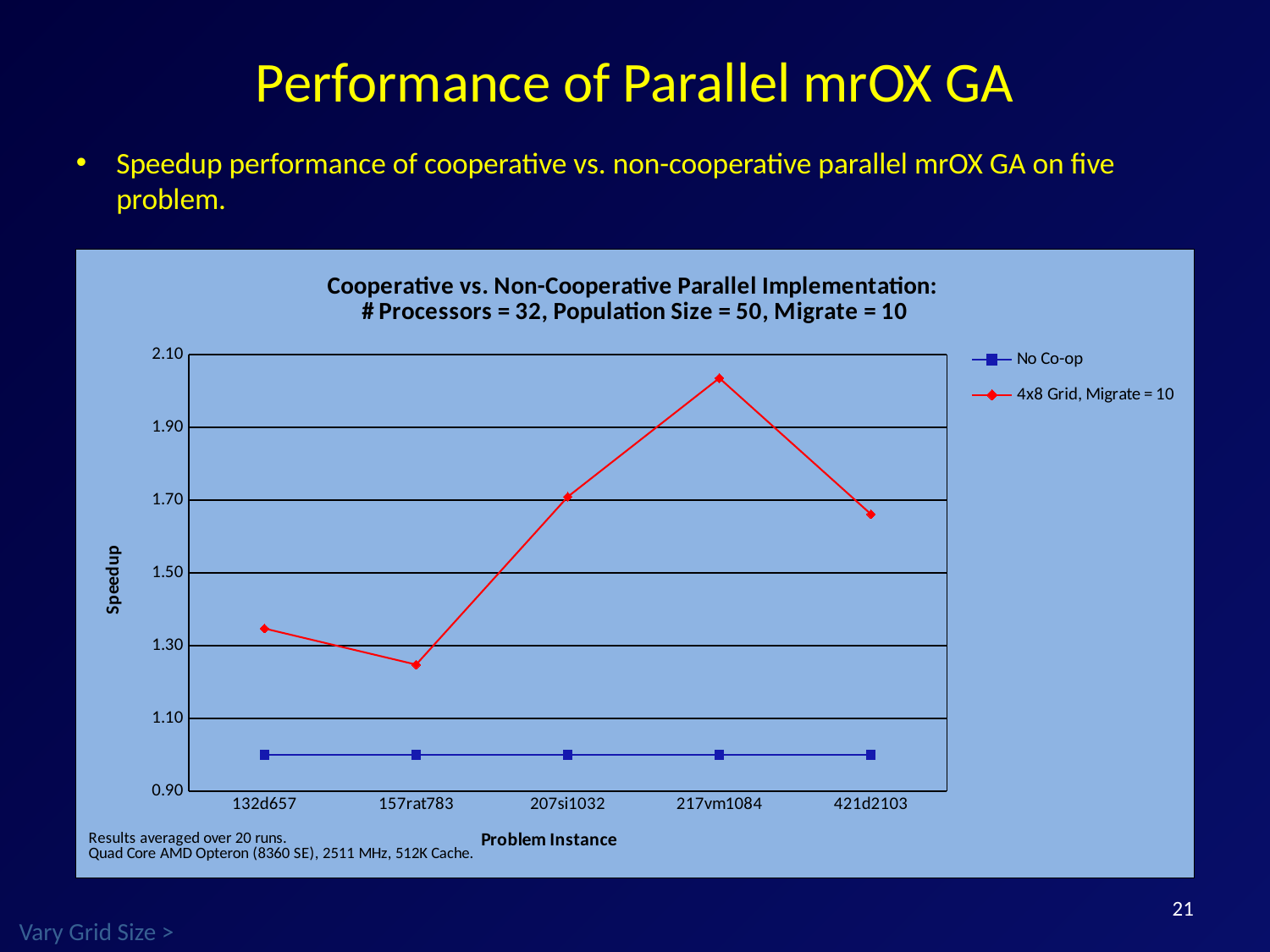
How many series does the legend list? 2 What is the label on the y axis of the chart? Speedup Is the No Co-op speedup for 421d2103 greater or less than 1.10? less What kind of chart is shown on the slide? line chart Does the No Co-op line rise, fall, or stay flat across the problem instances? stays flat For the 4x8 Grid, Migrate = 10 series, which problem instance has the highest speedup? 217vm1084 Is the 4x8 Grid, Migrate = 10 speedup for 157rat783 greater or less than 1.30? less Is the 4x8 Grid, Migrate = 10 speedup for 132d657 greater or less than 1.30? greater For the 4x8 Grid, Migrate = 10 series, which has the larger speedup: 207si1032 or 157rat783? 207si1032 How many problem instances are plotted along the x axis? 5 For the 4x8 Grid, Migrate = 10 series, which problem instance has the lowest speedup? 157rat783